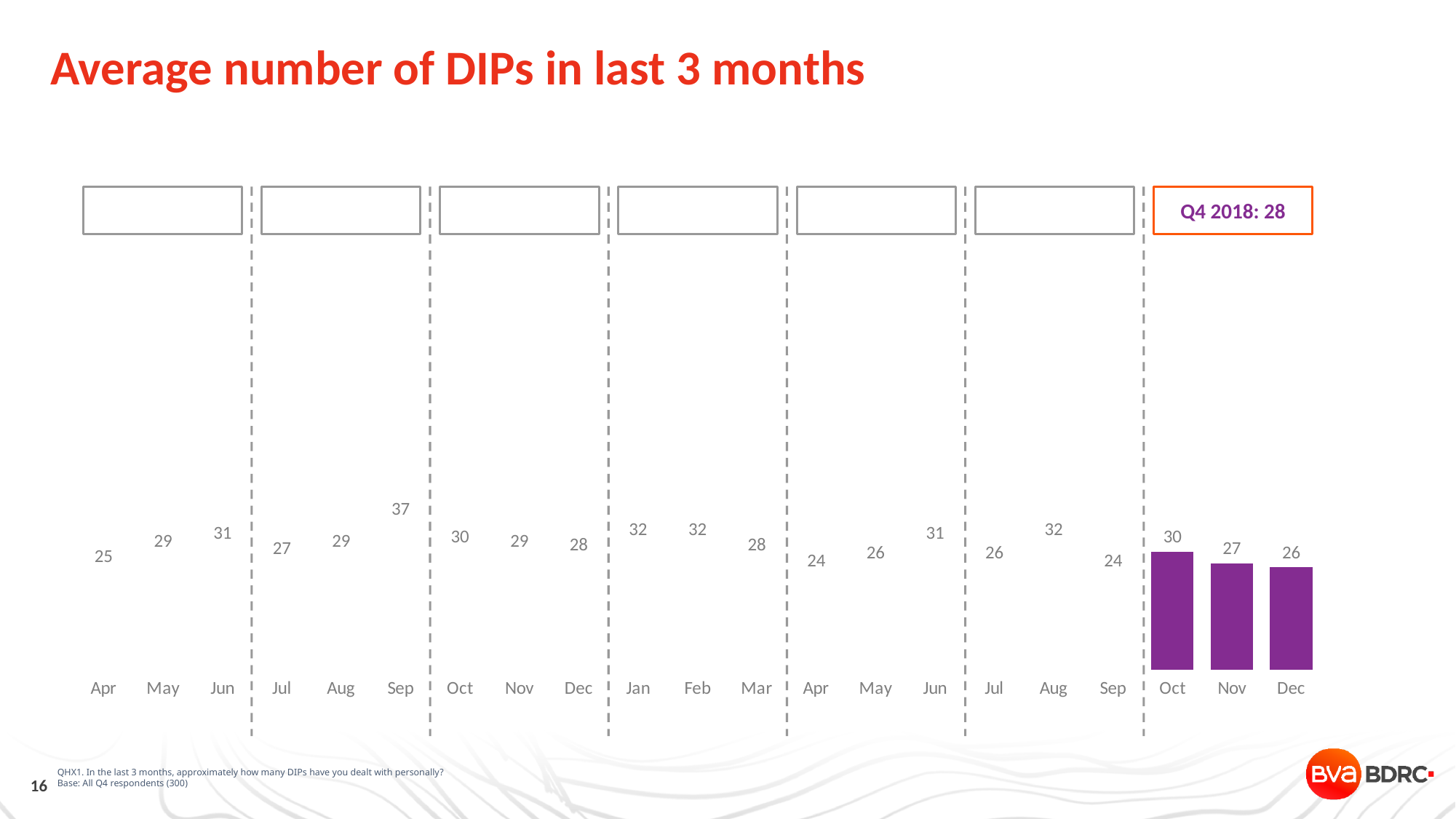
Within the Q4 2018 group, which month has the highest value? Oct What is the difference between the Oct and Dec values in the Q4 2018 group? 4 What average is shown in the highlighted Q4 2018 box? 28 Which is larger: the Oct value or the Nov value in the Q4 2018 group? Oct How many months are labelled along the x axis? 21 What is the value for Nov in the Q4 2018 group? 27 Within the Q4 2018 group, which month has the lowest value? Dec What is the value for Dec in the Q4 2018 group? 26 What is the highest value labelled on the chart, and which month does it belong to? 37, Sep What is the value for Oct in the Q4 2018 group? 30 What kind of chart is shown on the slide? Bar chart What is the title of the chart? Average number of DIPs in last 3 months